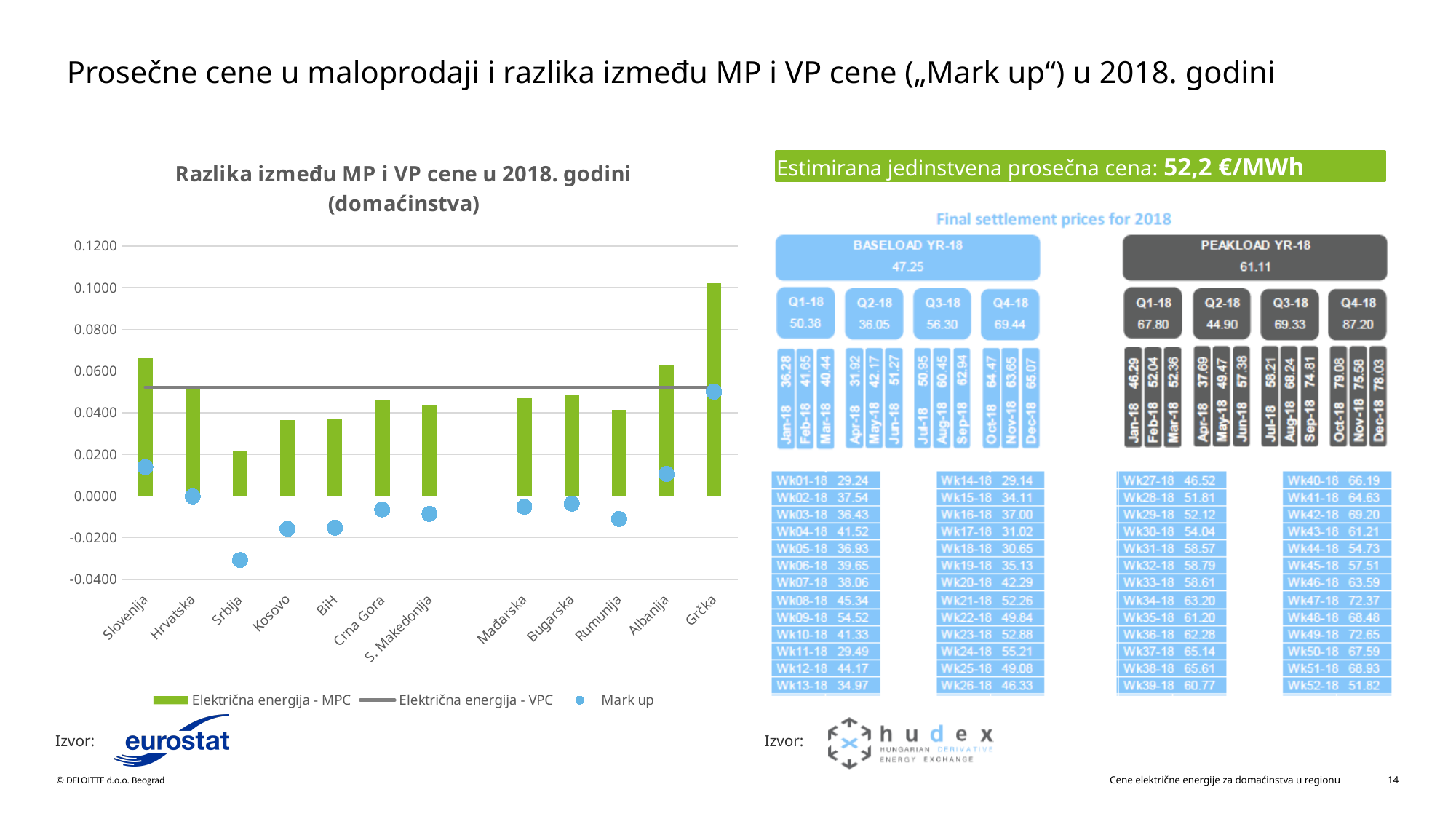
Which country has the highest bar for Električna energija - MPC in the left chart? Grčka Is the Električna energija - MPC value for Srbija greater or less than 0.0400? less Is the Mark up value for Srbija greater or less than -0.0200? less What kind of chart is shown on the left of the slide? bar chart How many series does the legend of the left chart list? 3 Which country has the lowest bar for Električna energija - MPC in the left chart? Srbija Which has the larger Električna energija - MPC bar, Bugarska or Kosovo? Bugarska What is the title of the chart on the left of the slide? Razlika između MP i VP cene u 2018. godini (domaćinstva) Is the Mark up value for Slovenija greater or less than 0.0000? greater Which has the larger Električna energija - MPC bar, Slovenija or Hrvatska? Slovenija Which country has the lowest Mark up point in the left chart? Srbija